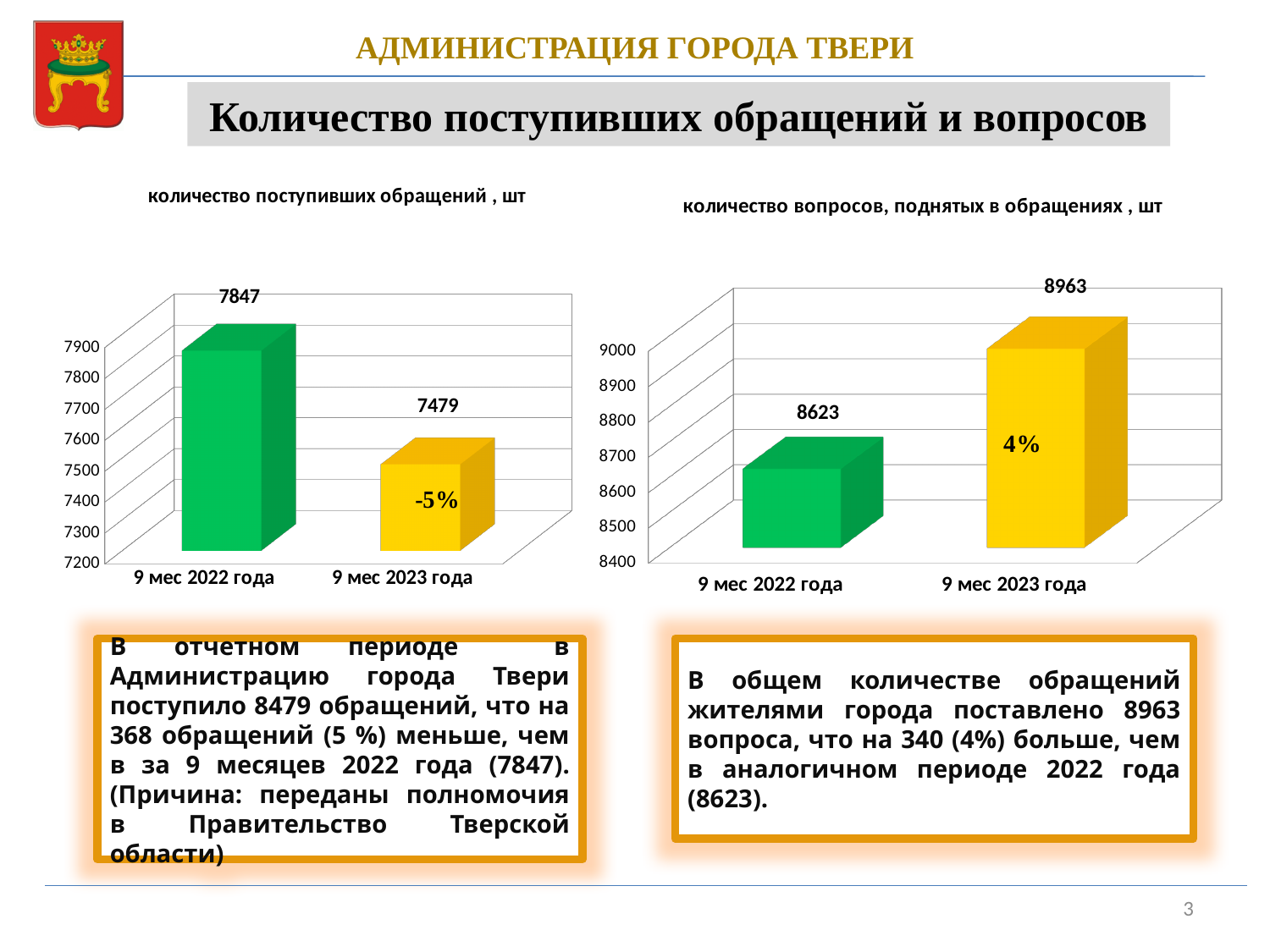
In the chart 'количество вопросов, поднятых в обращениях , шт', what is the value for 9 мес 2022 года? 8623 How many categories are shown in the chart 'количество вопросов, поднятых в обращениях , шт'? 2 In the chart 'количество поступивших обращений , шт', what is the value for 9 мес 2022 года? 7847 In the chart 'количество вопросов, поднятых в обращениях , шт', is the value for 9 мес 2023 года greater or less than the value for 9 мес 2022 года? greater In the chart 'количество вопросов, поднятых в обращениях , шт', what is the value for 9 мес 2023 года? 8963 In the chart 'количество поступивших обращений , шт', what is the difference between the values for 9 мес 2022 года and 9 мес 2023 года? 368 In the chart 'количество поступивших обращений , шт', what is the value for 9 мес 2023 года? 7479 In the chart 'количество поступивших обращений , шт', do the values rise or fall from 9 мес 2022 года to 9 мес 2023 года? fall In the chart 'количество вопросов, поднятых в обращениях , шт', by how much does the value for 9 мес 2023 года exceed the value for 9 мес 2022 года? 340 In the chart 'количество поступивших обращений , шт', which period has the higher value? 9 мес 2022 года What type of chart is the left chart 'количество поступивших обращений , шт'? bar chart In the chart 'количество вопросов, поднятых в обращениях , шт', which period has the lower value? 9 мес 2022 года